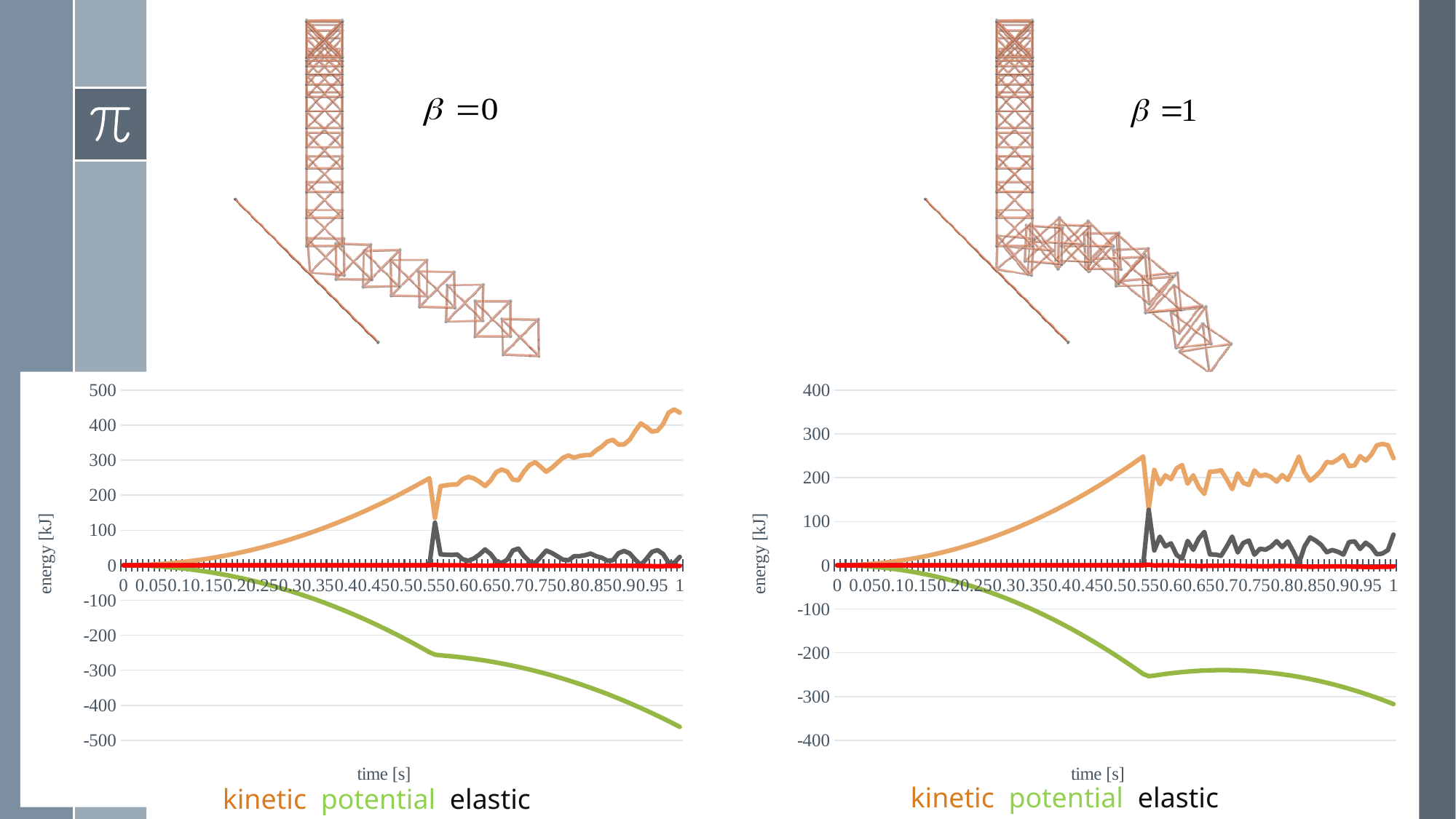
Which chart shows the higher kinetic energy at time 1 s, the β=0 chart or the β=1 chart? β=0 How many series does the legend below the β=1 chart list? 3 In the β=0 chart, is the kinetic energy at time 0.4 s greater or less than 100? greater In the β=0 chart, is the potential energy at time 1 s greater or less than -400? less Which colour represents the potential energy series in the β=1 chart? green What kind of chart is the β=0 chart on the left? line chart In the β=1 chart, is the kinetic energy at time 1 s greater or less than 200? greater In the β=0 chart, does the kinetic energy rise or fall over time? rise What is the y-axis label of the β=0 chart? energy [kJ] In the β=1 chart, does the potential energy rise or fall over time? fall